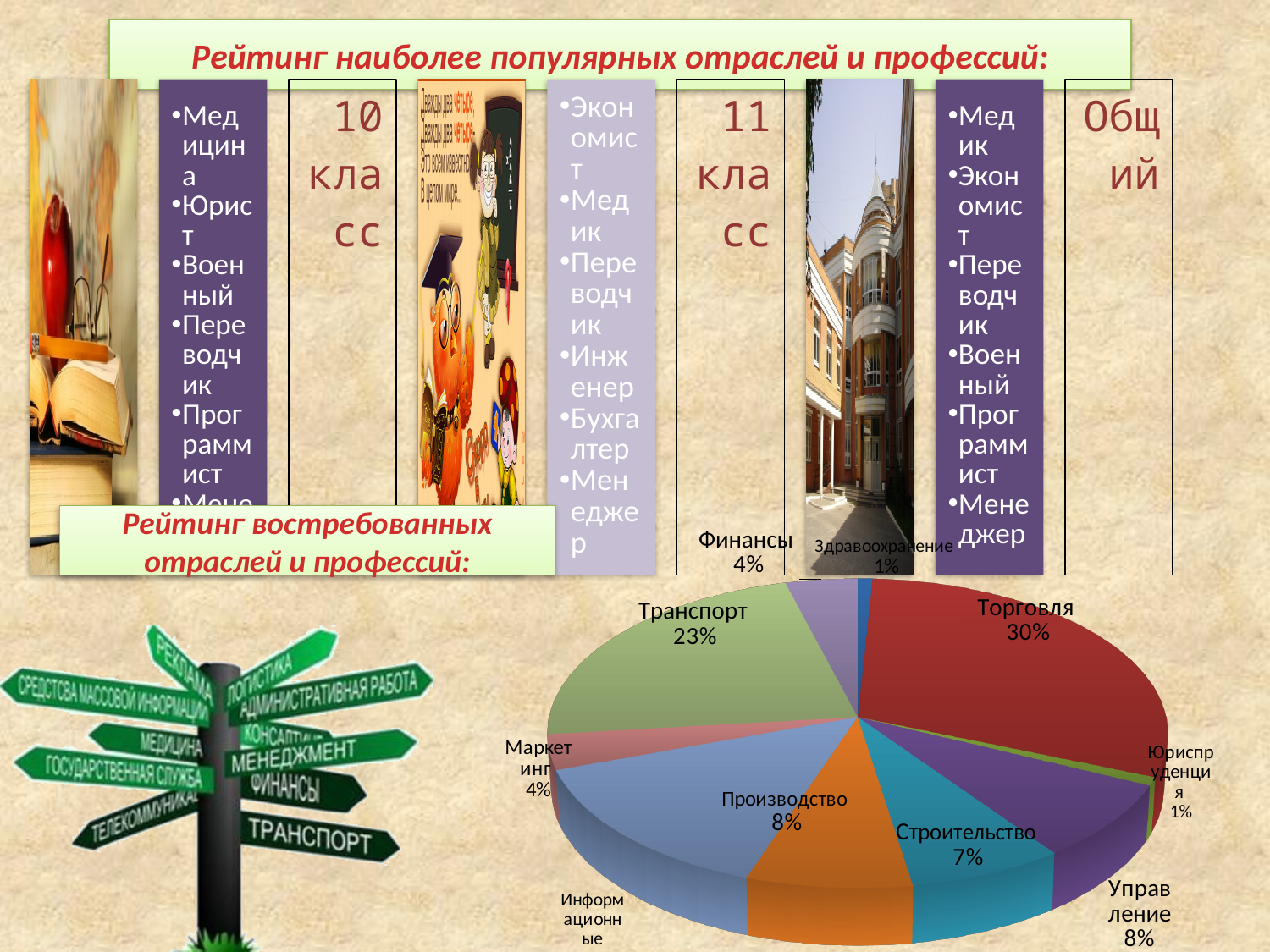
What kind of chart is shown at the bottom right of the slide? Pie chart Which category has the largest slice in the pie chart? Торговля In the pie chart, how many percentage points larger is Торговля than Транспорт? 7 In the pie chart, which is larger: Транспорт or Производство? Транспорт How many labelled slices does the pie chart have? 10 In the pie chart, what share does Торговля have? 30% What is the title shown in the box above the pie chart? Рейтинг востребованных отраслей и профессий: In the pie chart, what share does Строительство have? 7% In the pie chart, what share does Транспорт have? 23% In the pie chart, what share does Здравоохранение have? 1% In the pie chart, what share does Маркетинг have? 4% In the pie chart, what is the combined share of Торговля and Транспорт? 53%